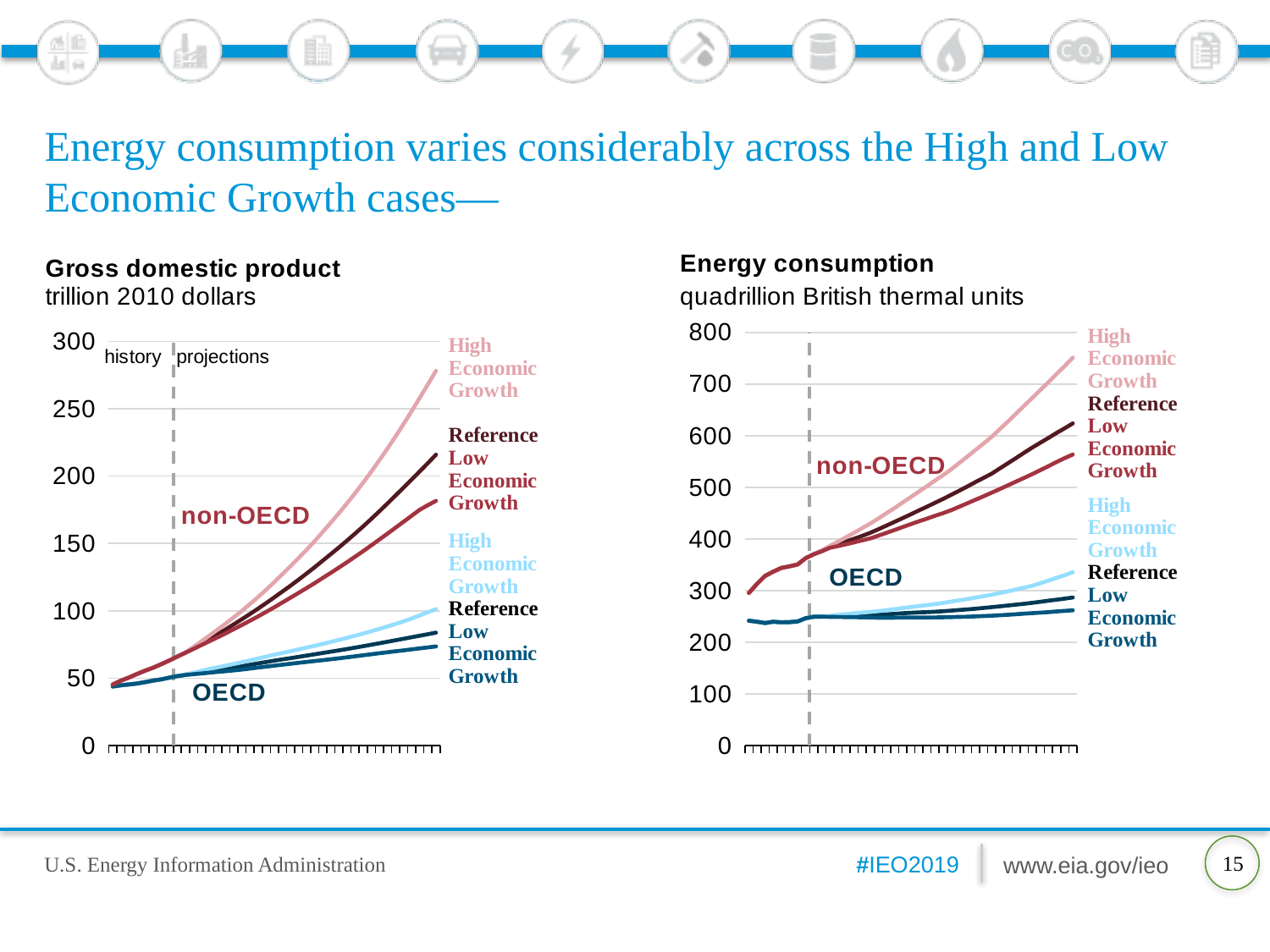
In the Gross domestic product chart, does the non-OECD Reference line rise or fall over the projection period? rise What kind of chart is the Gross domestic product chart on the left? line chart In the Gross domestic product chart, what unit is the y axis measured in? trillion 2010 dollars In the Energy consumption chart, is the final projected value for the non-OECD Low Economic Growth line greater or less than 600? less In the Energy consumption chart, which line reaches the highest value at the end of the projection period? non-OECD High Economic Growth How many lines (series) are plotted in the Energy consumption chart? 6 In the Energy consumption chart, is the final projected value for the OECD Low Economic Growth line greater or less than 300? less In the Gross domestic product chart, is the final projected value for the non-OECD High Economic Growth line greater or less than 250? greater In the Energy consumption chart, what unit is the y axis measured in? quadrillion British thermal units What kind of chart is the Energy consumption chart on the right? line chart